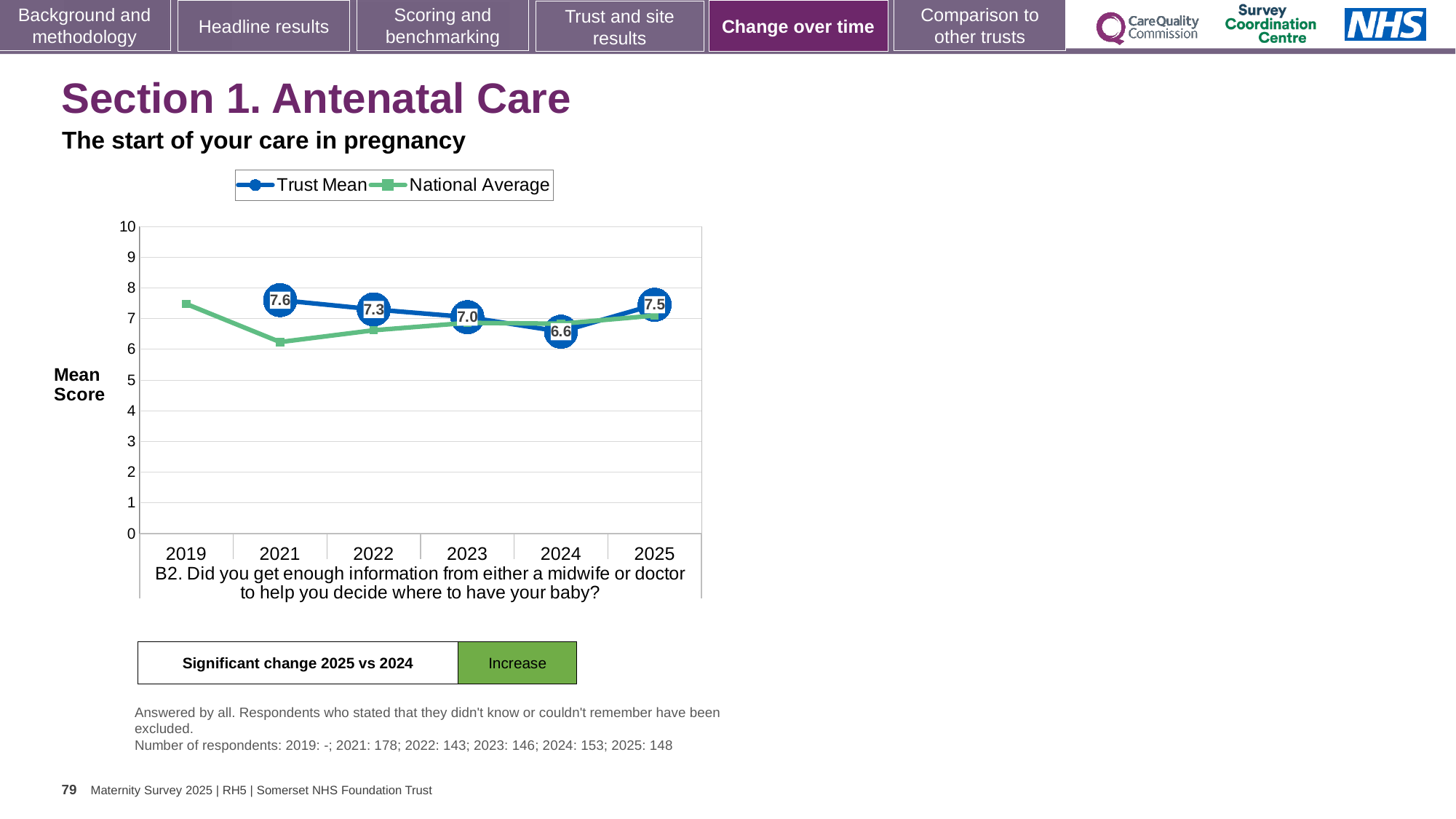
Which is larger, the Trust Mean for 2022 or for 2023? 2022 What is the Trust Mean for 2021? 7.6 What kind of chart is shown on the slide? Line chart In which year is the Trust Mean lowest? 2024 Is the National Average for 2021 greater or less than 7? less In which year is the Trust Mean highest? 2021 What is the Trust Mean for 2024? 6.6 By how much did the Trust Mean change from 2024 to 2025? 0.9 How many series does the legend list? 2 Does the Trust Mean rise or fall from 2021 to 2024? Fall What is the difference between the Trust Mean in 2021 and in 2022? 0.3 What is the Trust Mean for 2025? 7.5